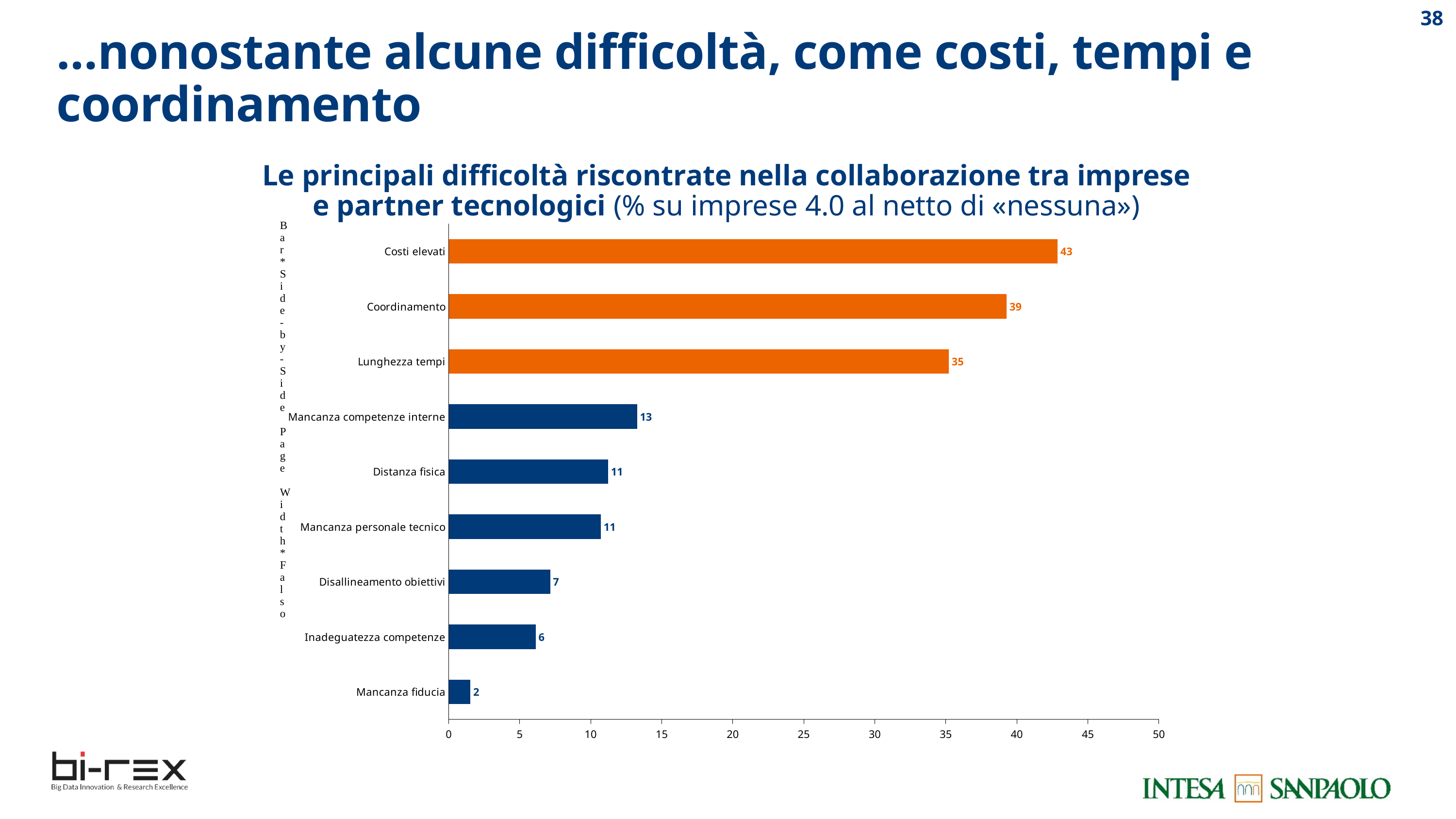
What is the difference between the values for Lunghezza tempi and Mancanza competenze interne? 22 What is the value for Costi elevati? 43 Which category has the highest value? Costi elevati What is the difference between the values for Costi elevati and Coordinamento? 4 What is the value for Coordinamento? 39 How many categories are shown in the chart? 9 What is the value for Lunghezza tempi? 35 Which is larger, the value for Disallineamento obiettivi or the value for Inadeguatezza competenze? Disallineamento obiettivi Which category has the lowest value? Mancanza fiducia How many bars are coloured orange? 3 What is the value for Mancanza competenze interne? 13 What kind of chart is shown on the slide? Bar chart